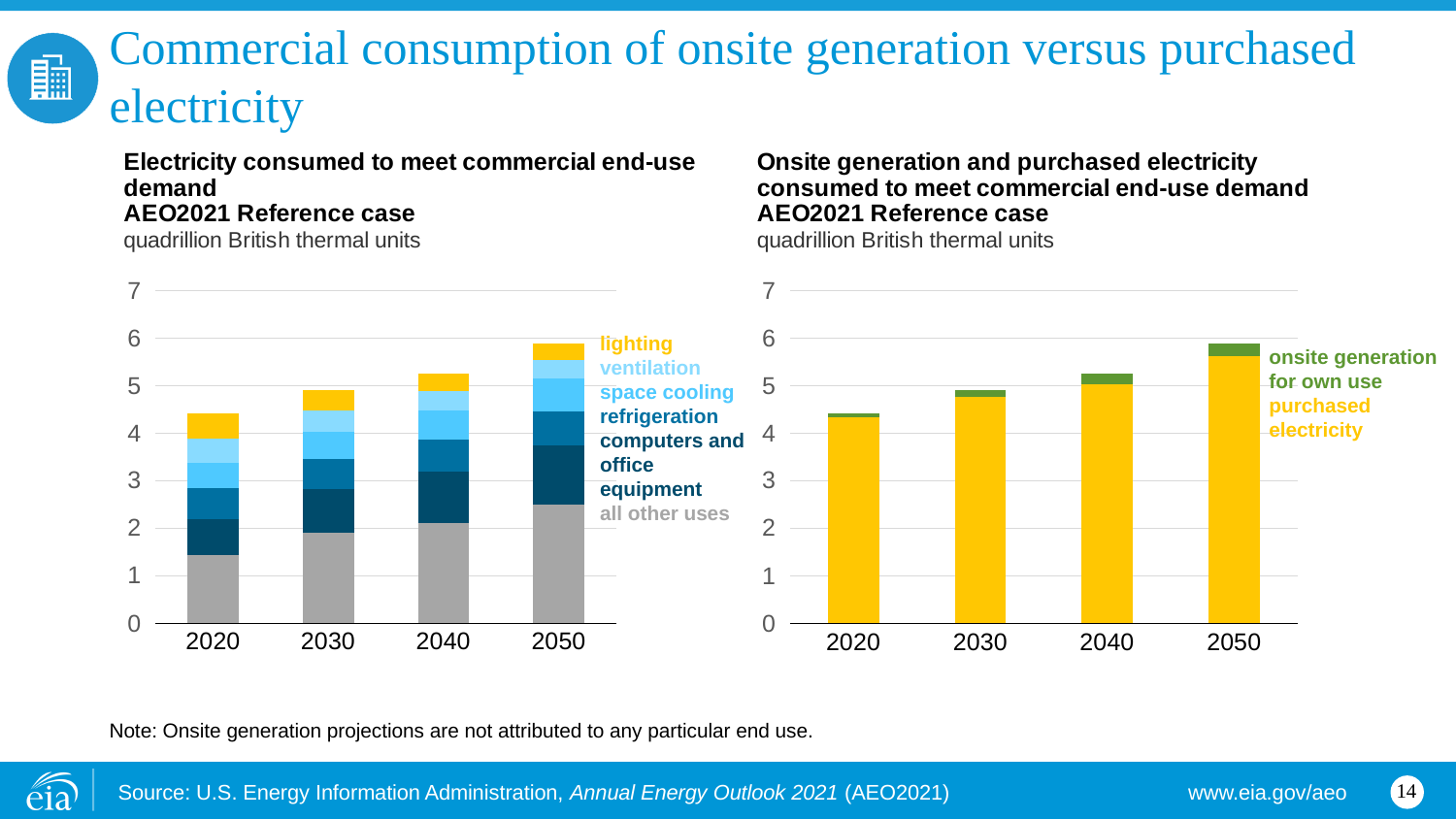
In the left chart, 'Electricity consumed to meet commercial end-use demand', which is larger: the total bar for 2050 or the total bar for 2020? 2050 In the right chart, 'Onsite generation and purchased electricity consumed to meet commercial end-use demand', is the total value for 2050 greater or less than 5? greater In the left chart, 'Electricity consumed to meet commercial end-use demand', do the total bar heights rise or fall from 2020 to 2050? rise What unit of measurement is used on both charts? quadrillion British thermal units In the right chart, 'Onsite generation and purchased electricity consumed to meet commercial end-use demand', which year has the highest total bar? 2050 In the right chart, 'Onsite generation and purchased electricity consumed to meet commercial end-use demand', which is larger in 2050: purchased electricity or onsite generation for own use? purchased electricity How many years are shown on the x axis of the right chart, 'Onsite generation and purchased electricity consumed to meet commercial end-use demand'? 4 How many series does the legend of the left chart, 'Electricity consumed to meet commercial end-use demand', list? 6 What kind of chart is the left chart, 'Electricity consumed to meet commercial end-use demand'? stacked bar chart In the left chart, 'Electricity consumed to meet commercial end-use demand', is the total value for 2020 greater or less than 4? greater How many series does the legend of the right chart, 'Onsite generation and purchased electricity consumed to meet commercial end-use demand', list? 2 In the left chart, 'Electricity consumed to meet commercial end-use demand', which year has the lowest total bar? 2020